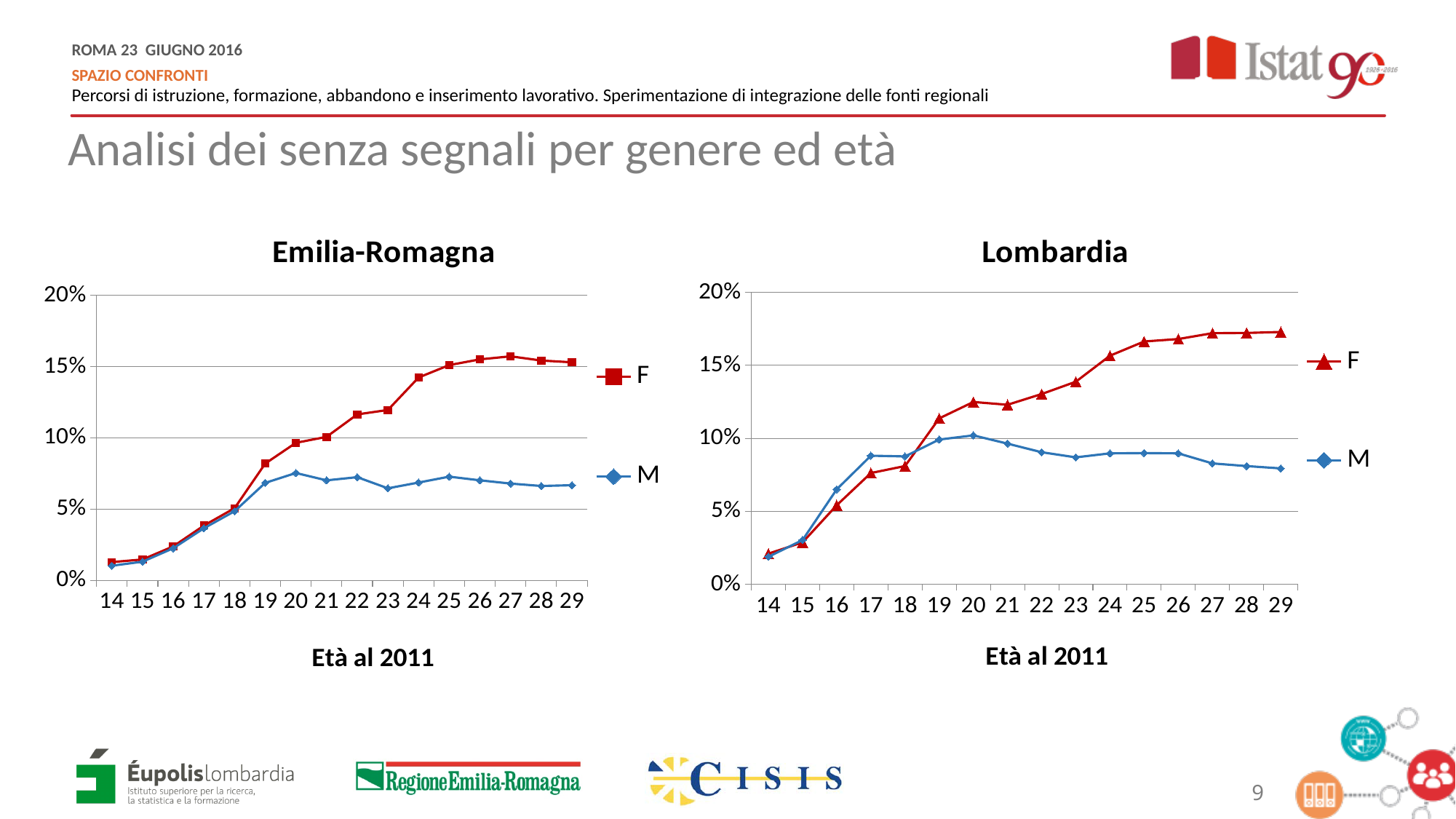
In the Lombardia chart, is the value for F at age 29 greater or less than 15%? greater In the Lombardia chart, which series has the larger value at age 17, F or M? M What is the x-axis title of the Emilia-Romagna chart? Età al 2011 In the Lombardia chart, is the value for M at age 29 greater or less than 10%? less In the Emilia-Romagna chart, is the value for M at age 20 greater or less than 5%? greater In the Emilia-Romagna chart, which series has the larger value at age 29, F or M? F What kind of chart is the Emilia-Romagna chart? line chart In the Lombardia chart, does the F series generally rise or fall as age increases? rise How many age categories are shown on the x axis of the Emilia-Romagna chart? 16 How many series does the legend of the Lombardia chart list? 2 In the Lombardia chart, at which age is the F series lowest? 14